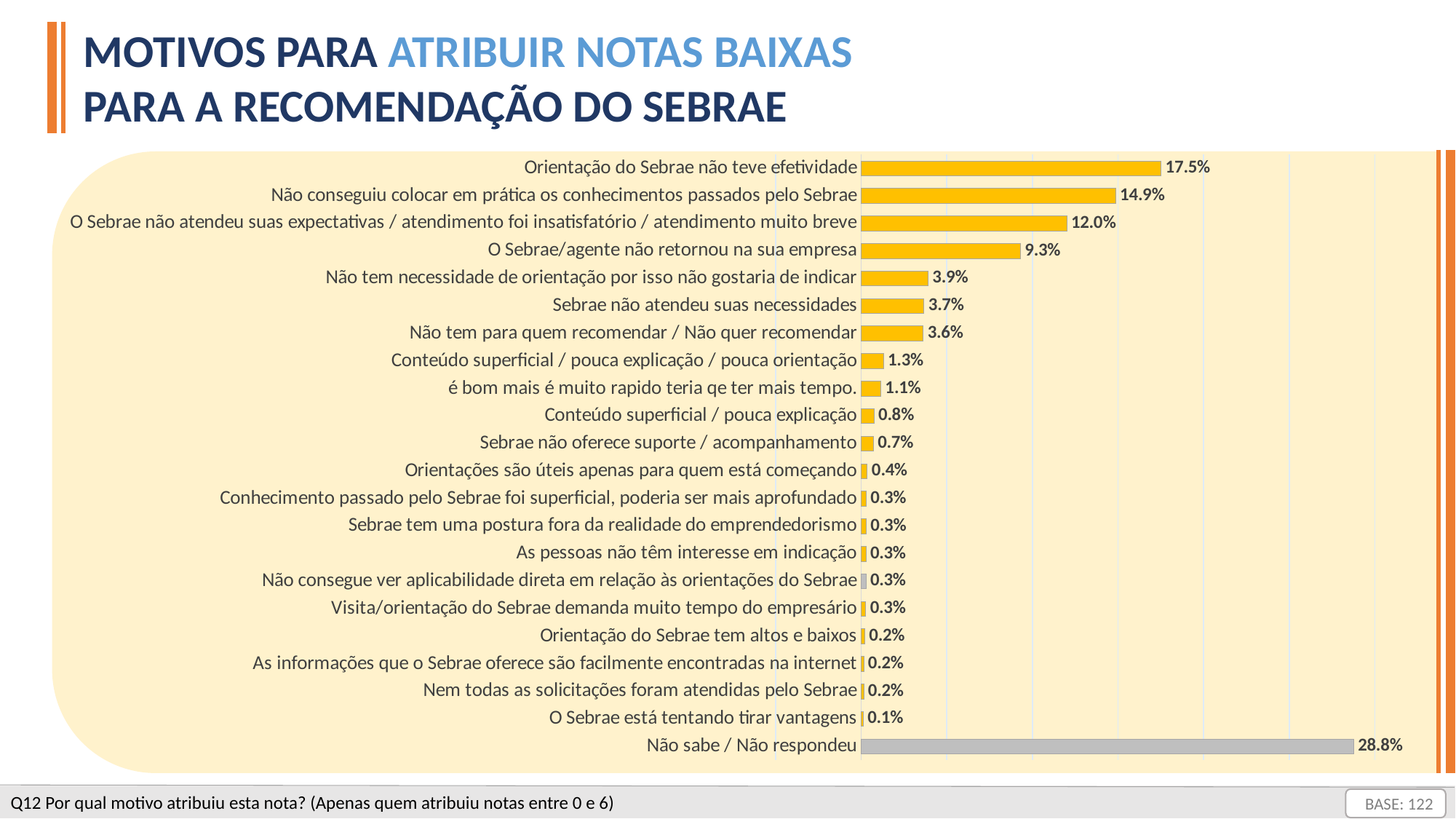
What is the difference between the values for "Orientação do Sebrae não teve efetividade" and "Não conseguiu colocar em prática os conhecimentos passados pelo Sebrae"? 2.6% What is the value for "Não sabe / Não respondeu"? 28.8% Which bar in the chart is coloured grey rather than yellow? Não sabe / Não respondeu (the small 0.3% bar for "Não consegue ver aplicabilidade direta em relação às orientações do Sebrae" is also grey) How many categories (bars) are shown in the chart? 22 Which category has the highest value in the chart? Não sabe / Não respondeu Which is larger: the value for "Sebrae não atendeu suas necessidades" or the value for "Não tem necessidade de orientação por isso não gostaria de indicar"? Não tem necessidade de orientação por isso não gostaria de indicar What kind of chart is shown on the slide? bar chart Which category has the lowest value in the chart? O Sebrae está tentando tirar vantagens What is the value for "Orientação do Sebrae não teve efetividade"? 17.5% What is the value for "Sebrae não oferece suporte / acompanhamento"? 0.7% What is the value for "O Sebrae/agente não retornou na sua empresa"? 9.3% What is the difference between the values for "Não sabe / Não respondeu" and "O Sebrae não atendeu suas expectativas / atendimento foi insatisfatório / atendimento muito breve"? 16.8%